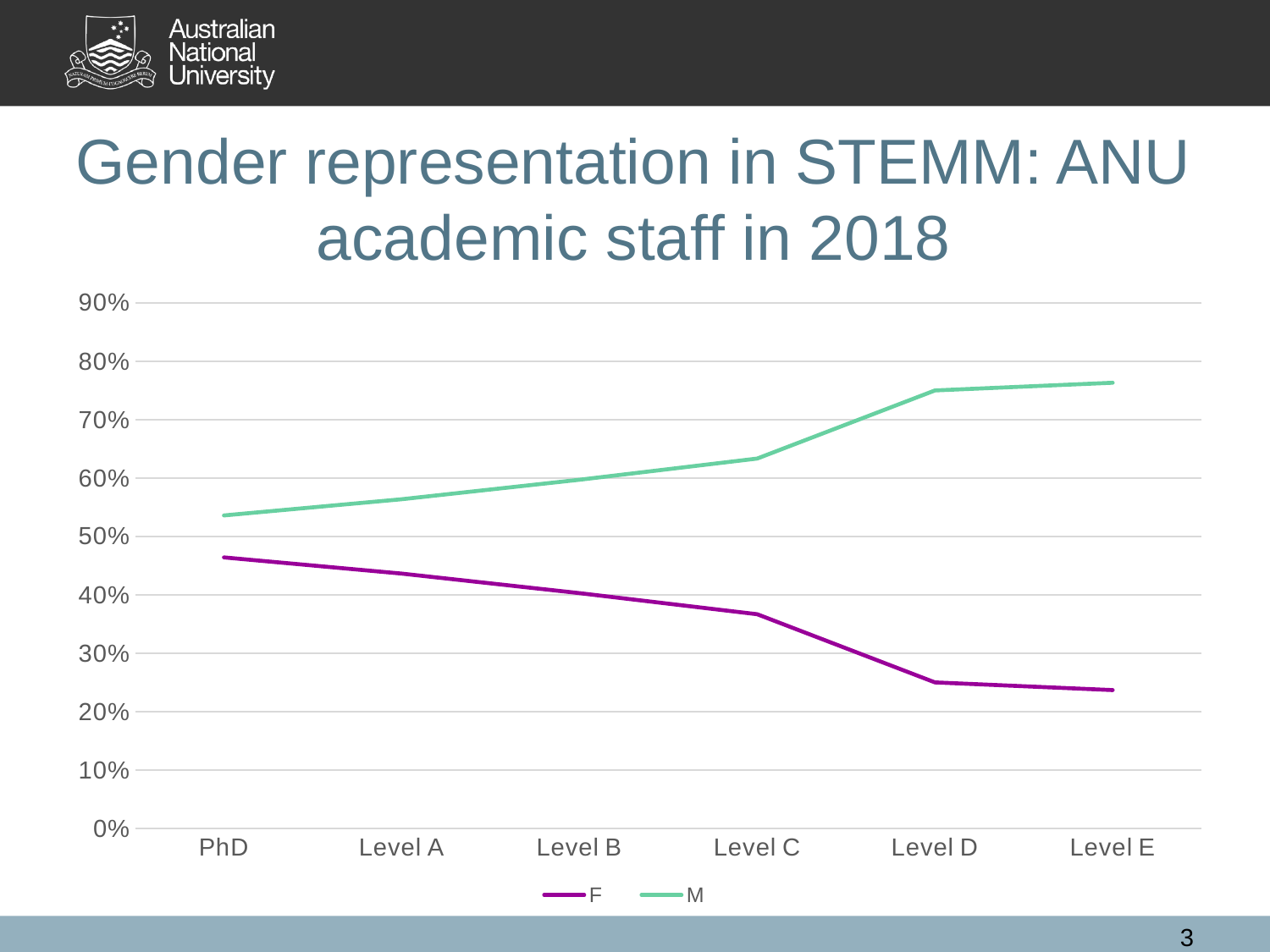
How many categories are shown along the x axis? 6 At which category is the F series highest? PhD At which category is the M series lowest? PhD Is the value for F at PhD greater or less than 50%? less Is the value for M at PhD greater or less than 50%? greater At Level E, which series has the larger value, F or M? M Is the value for M at Level D greater or less than 70%? greater What kind of chart is shown on the slide? line chart How many series does the legend list? 2 Does the F series rise or fall from PhD to Level E? fall